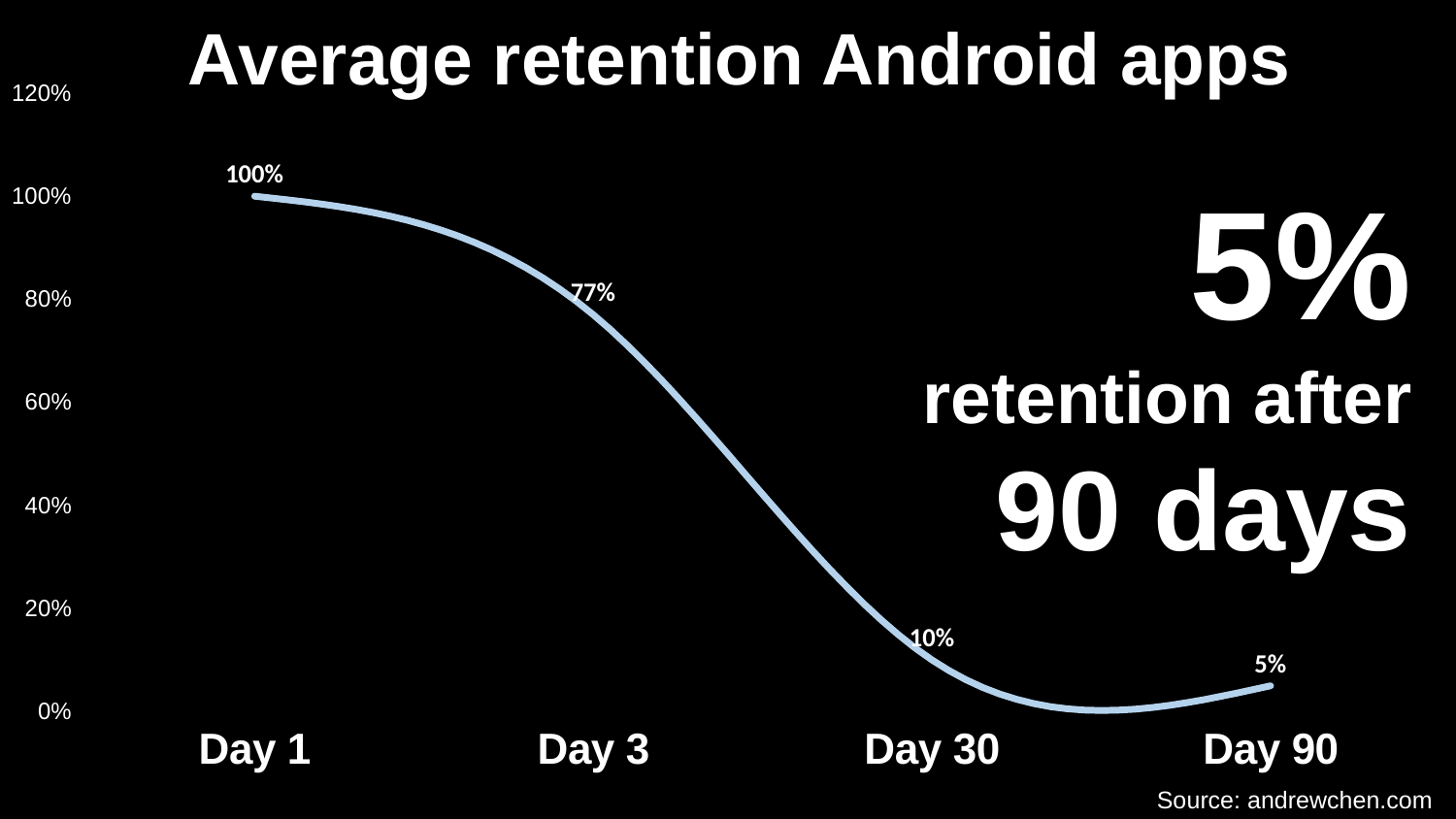
What is the difference between the retention at Day 3 and at Day 30? 67% What is the retention value at Day 3? 77% What is the difference between the retention at Day 1 and at Day 90? 95% How many data points are plotted on the chart? 4 Which day has the highest retention value? Day 1 What is the retention value at Day 90? 5% What is the retention value at Day 30? 10% What kind of chart is shown on the slide? Line chart What is the retention value at Day 1? 100% Which day has the lowest retention value? Day 90 Do the values rise or fall from Day 1 to Day 90? Fall Which is larger, the retention at Day 30 or at Day 90? Day 30